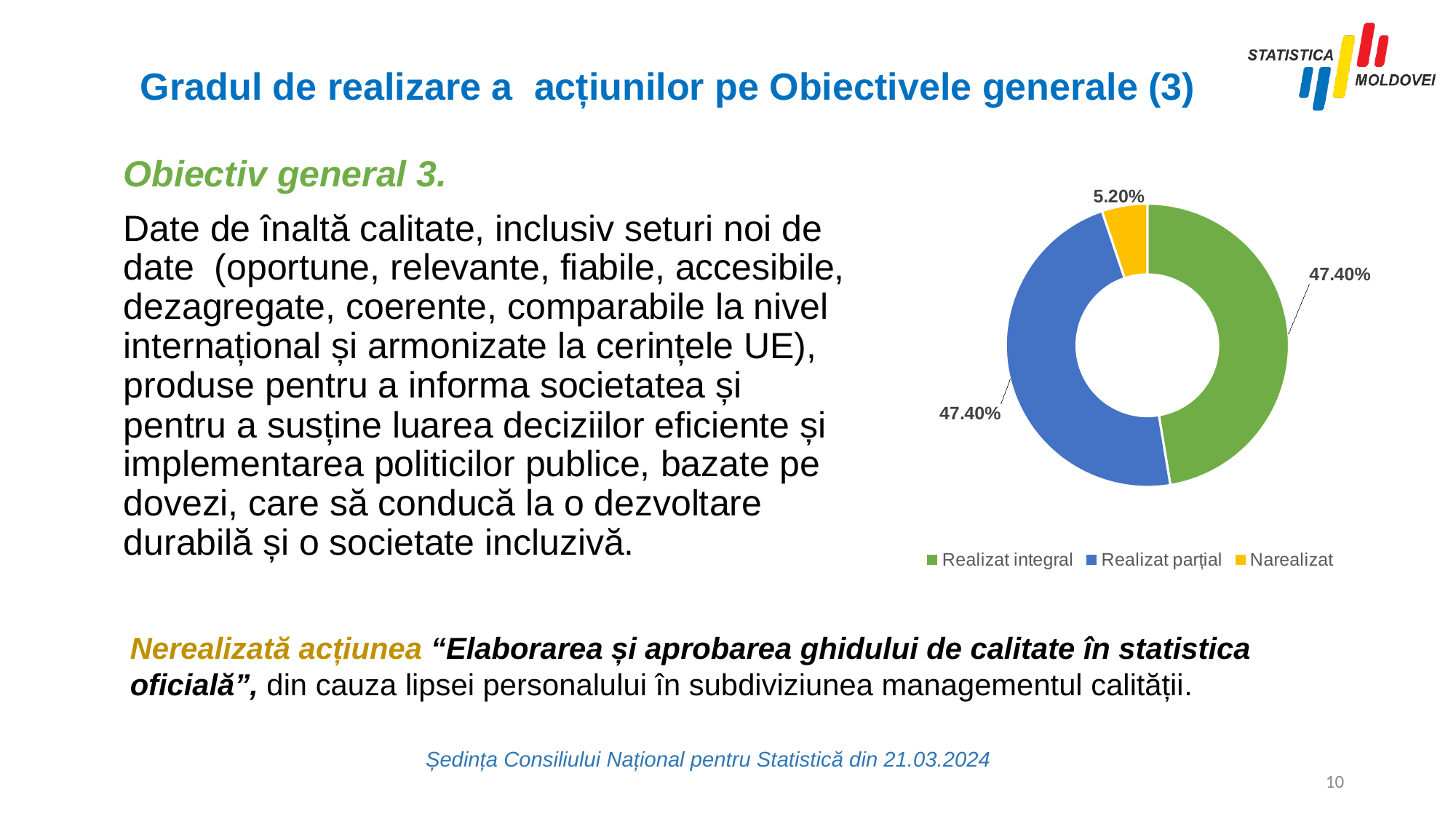
How many entries does the legend list? 3 What kind of chart is shown on the slide? Doughnut (pie) chart Which category has the smallest share? Narealizat What is the value for Realizat integral? 47.40% Which colour represents Realizat integral in the chart? Green What is the value for Nerealizat? 5.20% Which is larger, the share for Realizat parțial or the share for Nerealizat? Realizat parțial What is the value for Realizat parțial? 47.40% What is the difference between the share for Realizat integral and the share for Nerealizat? 42.20% Which colour represents Nerealizat in the chart? Yellow How many categories does the chart show? 3 What is the combined share of Realizat integral and Realizat parțial? 94.80%